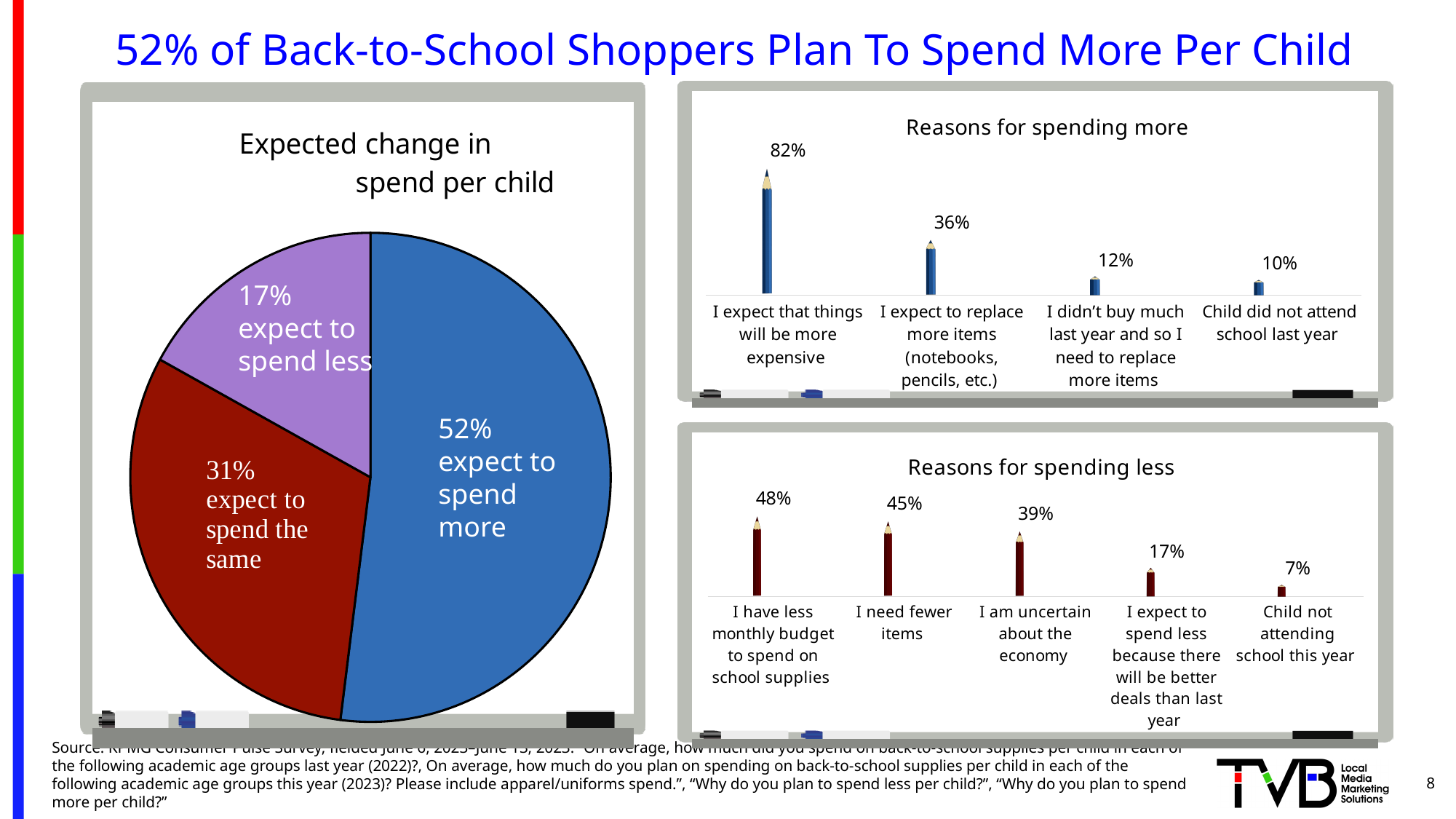
How many reasons are shown in the 'Reasons for spending less' chart? 5 In the 'Reasons for spending more' chart, what is the value for 'I expect to replace more items (notebooks, pencils, etc.)'? 36% In the 'Reasons for spending less' chart, which reason has the lowest value? Child not attending school this year In the 'Expected change in spend per child' chart, what share of shoppers expect to spend less? 17% In the 'Reasons for spending more' chart, which reason has the highest value? I expect that things will be more expensive In the 'Expected change in spend per child' chart, what share of shoppers expect to spend more? 52% What kind of chart is 'Expected change in spend per child'? Pie chart In the 'Reasons for spending less' chart, what is the value for 'I am uncertain about the economy'? 39% In the 'Reasons for spending more' chart, what is the difference between 'I expect that things will be more expensive' and 'Child did not attend school last year'? 72 percentage points In the 'Expected change in spend per child' chart, which response has the smallest slice? Expect to spend less How many reasons are shown in the 'Reasons for spending more' chart? 4 In the 'Reasons for spending less' chart, which is larger: 'I have less monthly budget to spend on school supplies' or 'I need fewer items'? I have less monthly budget to spend on school supplies